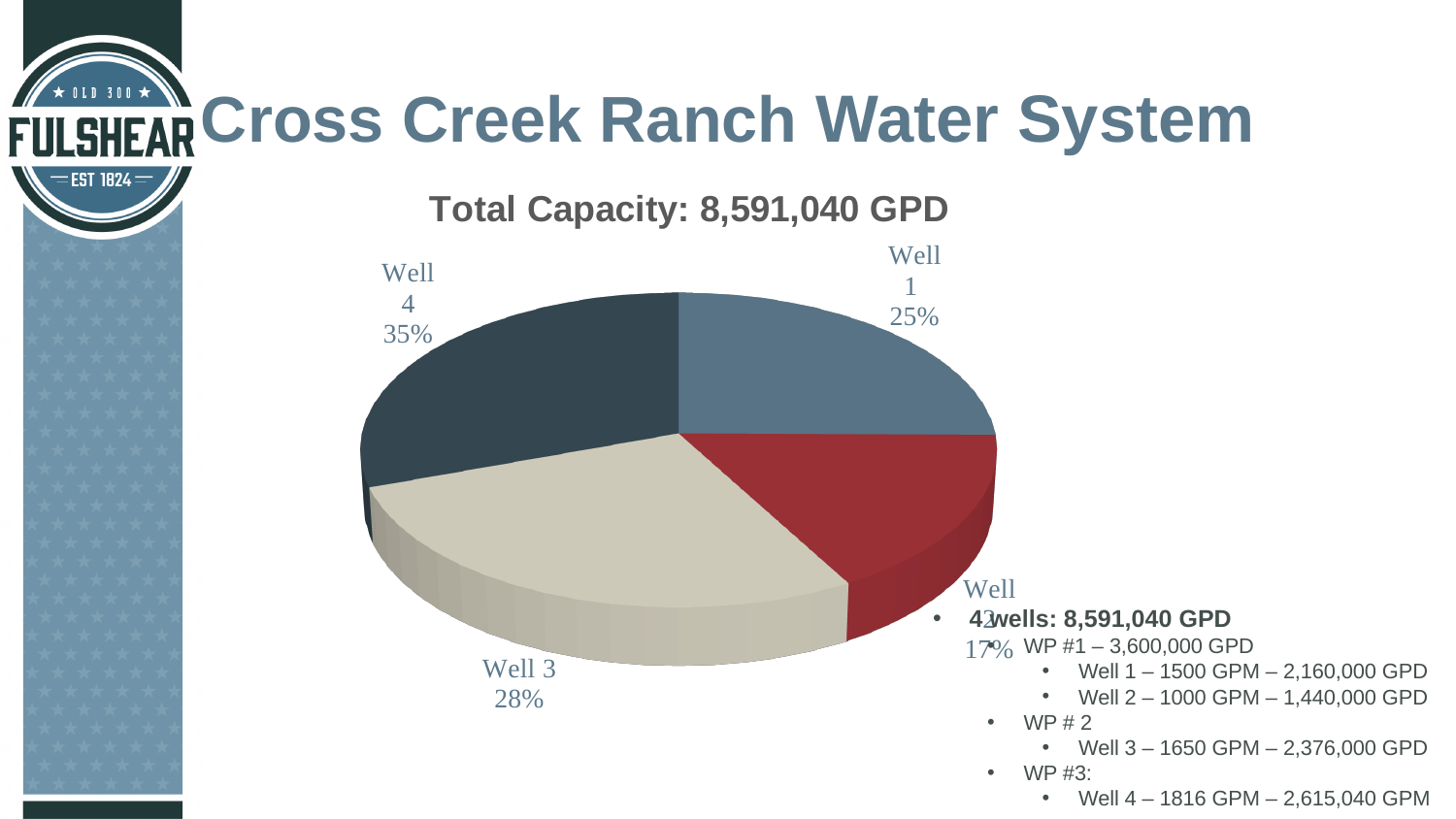
What is the difference in percentage points between Well 4 and Well 1? 10 What share of the pie does Well 1 represent? 25% Which is larger, the share for Well 3 or the share for Well 1? Well 3 What share of the pie does Well 3 represent? 28% What kind of chart is shown on the slide? pie chart What share of the pie does Well 2 represent? 17% How many slices does the pie chart have? 4 What is the difference in percentage points between Well 3 and Well 2? 11 Which well has the largest slice of the pie? Well 4 What is the title of the chart? Total Capacity: 8,591,040 GPD Which well has the smallest slice of the pie? Well 2